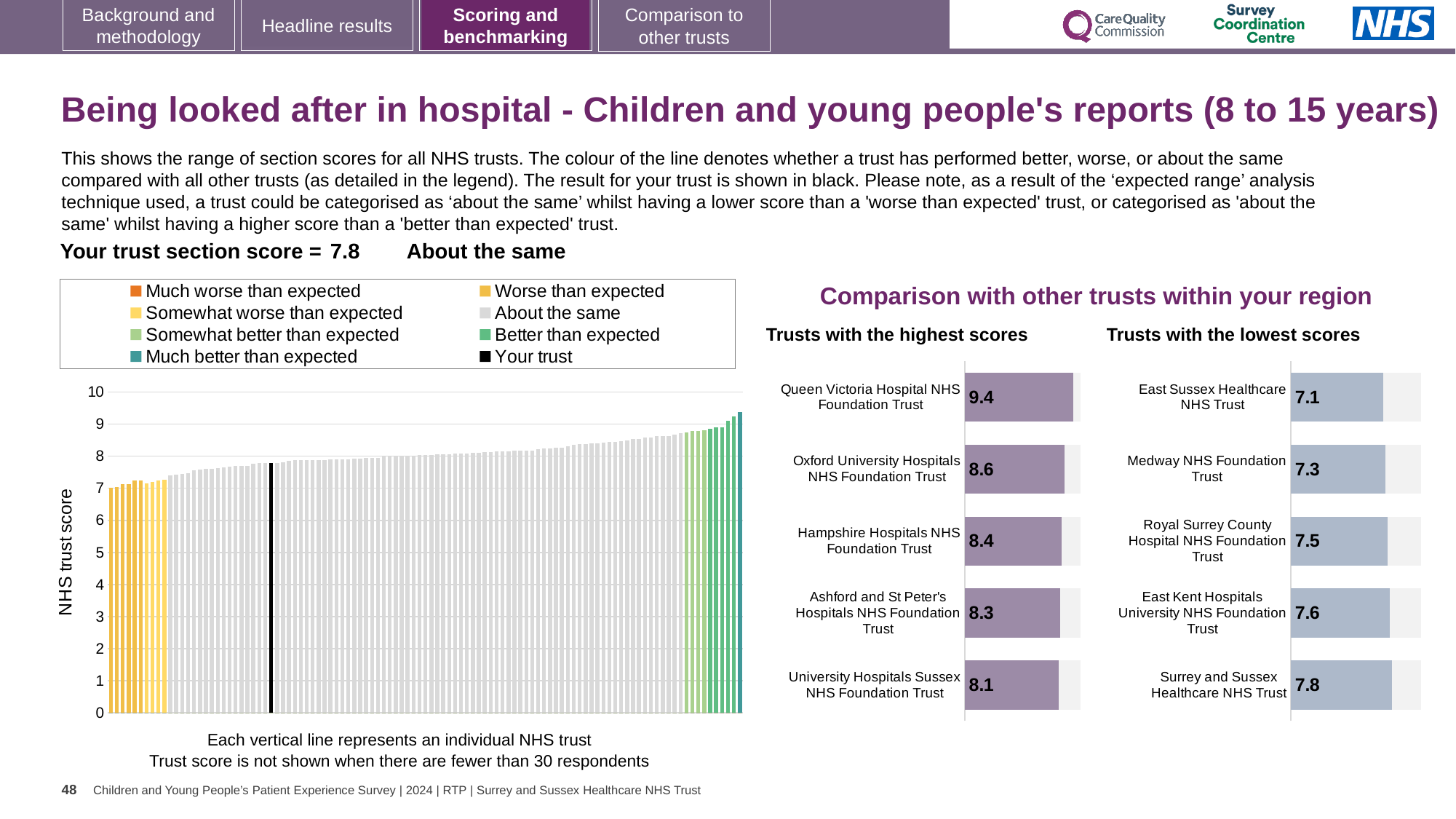
In the 'Trusts with the lowest scores' chart, how much higher is Surrey and Sussex Healthcare NHS Trust's score than East Sussex Healthcare NHS Trust's score? 0.7 What kind of chart is the large chart on the left showing NHS trust scores? bar chart In the 'Trusts with the highest scores' chart, what is the score for Queen Victoria Hospital NHS Foundation Trust? 9.4 In the 'Trusts with the highest scores' chart, which has the larger score: Hampshire Hospitals NHS Foundation Trust or Ashford and St Peter's Hospitals NHS Foundation Trust? Hampshire Hospitals NHS Foundation Trust In the large chart on the left, is the value of the lowest bar greater or less than 5? greater In the 'Trusts with the lowest scores' chart, what is the score for Royal Surrey County Hospital NHS Foundation Trust? 7.5 How many trusts are shown in the 'Trusts with the highest scores' chart? 5 In the 'Trusts with the lowest scores' chart, which trust has the lowest score? East Sussex Healthcare NHS Trust In the 'Trusts with the highest scores' chart, which trust has the highest score? Queen Victoria Hospital NHS Foundation Trust How many entries does the legend of the large chart on the left list? 8 In the 'Trusts with the lowest scores' chart, what is the score for Medway NHS Foundation Trust? 7.3 In the 'Trusts with the highest scores' chart, what is the difference between the scores of Queen Victoria Hospital NHS Foundation Trust and Oxford University Hospitals NHS Foundation Trust? 0.8